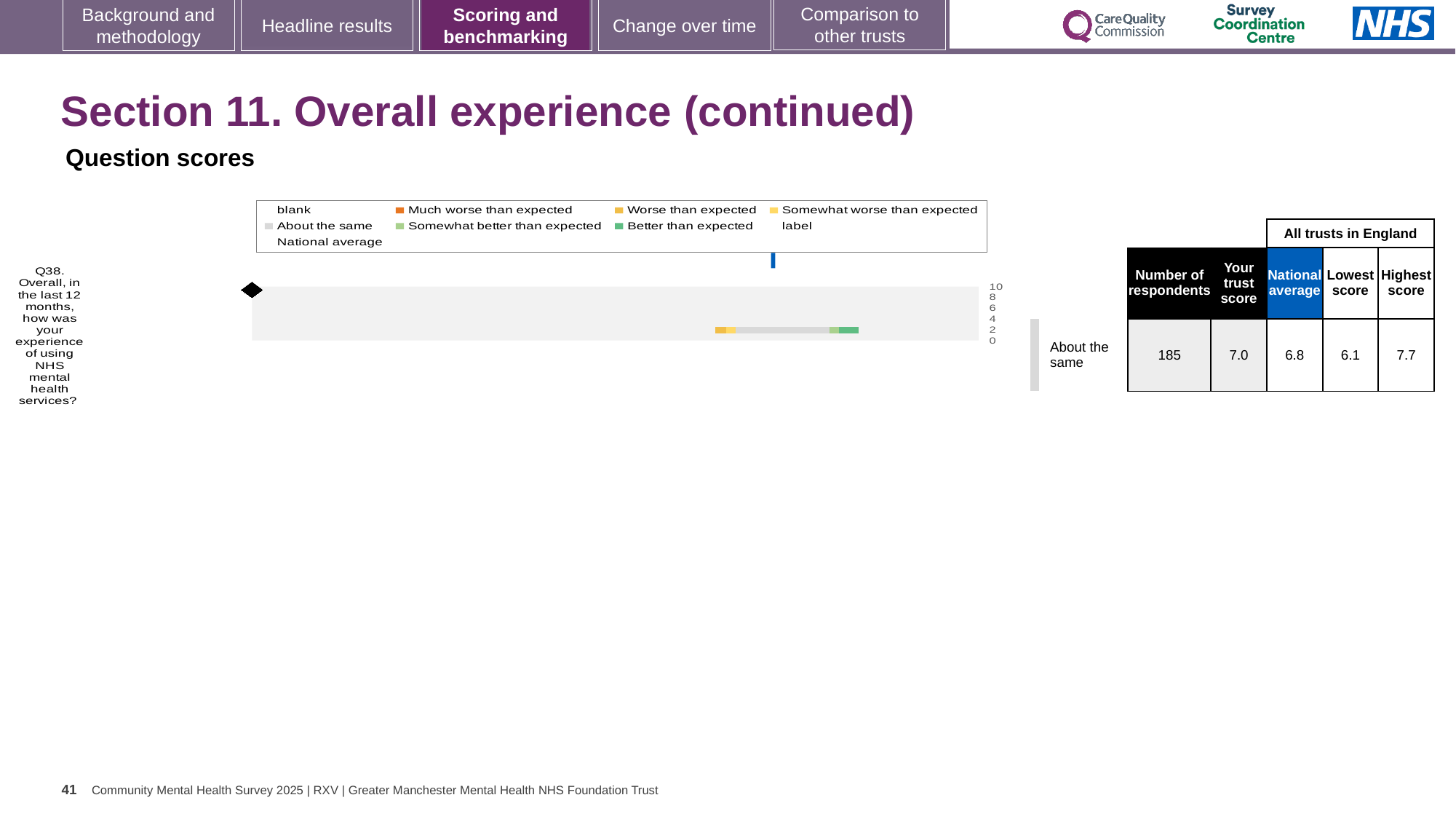
What benchmark category is the trust's Q38 score placed in? About the same How many survey questions are plotted in the chart? 1 What is the highest value shown on the chart's axis? 10 What kind of chart is shown on the slide? bar chart What is the difference between the highest score (7.7) and the lowest score (6.1) for Q38? 1.6 According to the table next to the chart, how many respondents answered Q38? 185 According to the table next to the chart, what is the lowest score among all trusts in England for Q38? 6.1 According to the table next to the chart, what is the highest score among all trusts in England for Q38? 7.7 According to the table next to the chart, what is the trust's score for Q38? 7.0 Which question number is plotted in the chart? Q38 According to the table next to the chart, what is the national average for Q38? 6.8 Which is larger for Q38, the trust's score or the national average? the trust's score